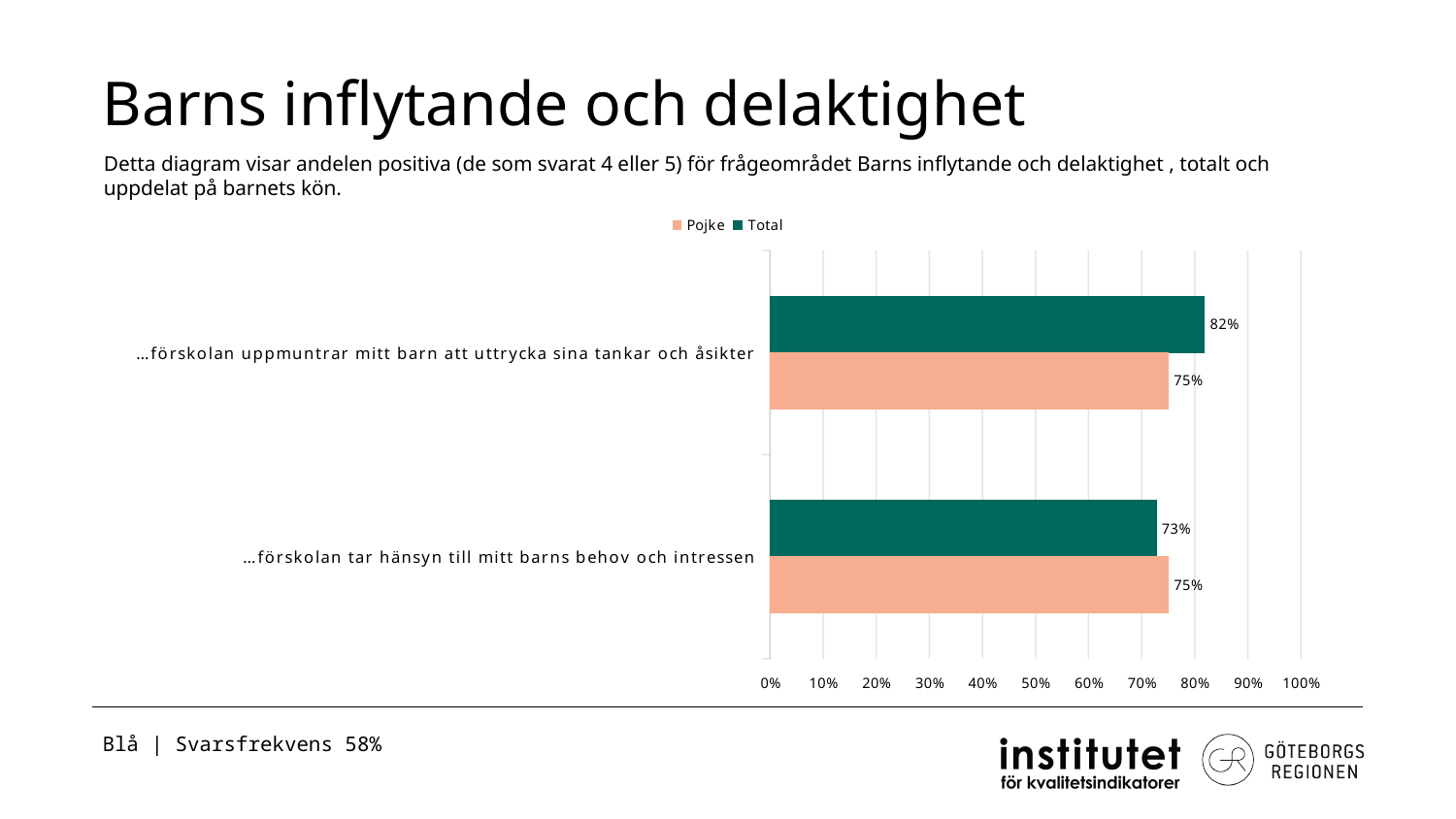
What kind of chart is shown on the slide? Bar chart What is the Total value for "…förskolan tar hänsyn till mitt barns behov och intressen"? 73% How many series does the legend list? 2 What is the Pojke value for "…förskolan uppmuntrar mitt barn att uttrycka sina tankar och åsikter"? 75% Which category has the highest Total value? …förskolan uppmuntrar mitt barn att uttrycka sina tankar och åsikter For "…förskolan tar hänsyn till mitt barns behov och intressen", which is larger, the Pojke value or the Total value? Pojke What is the difference between the Total and Pojke values for "…förskolan uppmuntrar mitt barn att uttrycka sina tankar och åsikter"? 7% What is the difference between the Pojke and Total values for "…förskolan tar hänsyn till mitt barns behov och intressen"? 2% How many categories are shown on the chart? 2 What is the Pojke value for "…förskolan tar hänsyn till mitt barns behov och intressen"? 75% Is the Total value for "…förskolan uppmuntrar mitt barn att uttrycka sina tankar och åsikter" greater or less than 80%? greater What is the Total value for "…förskolan uppmuntrar mitt barn att uttrycka sina tankar och åsikter"? 82%